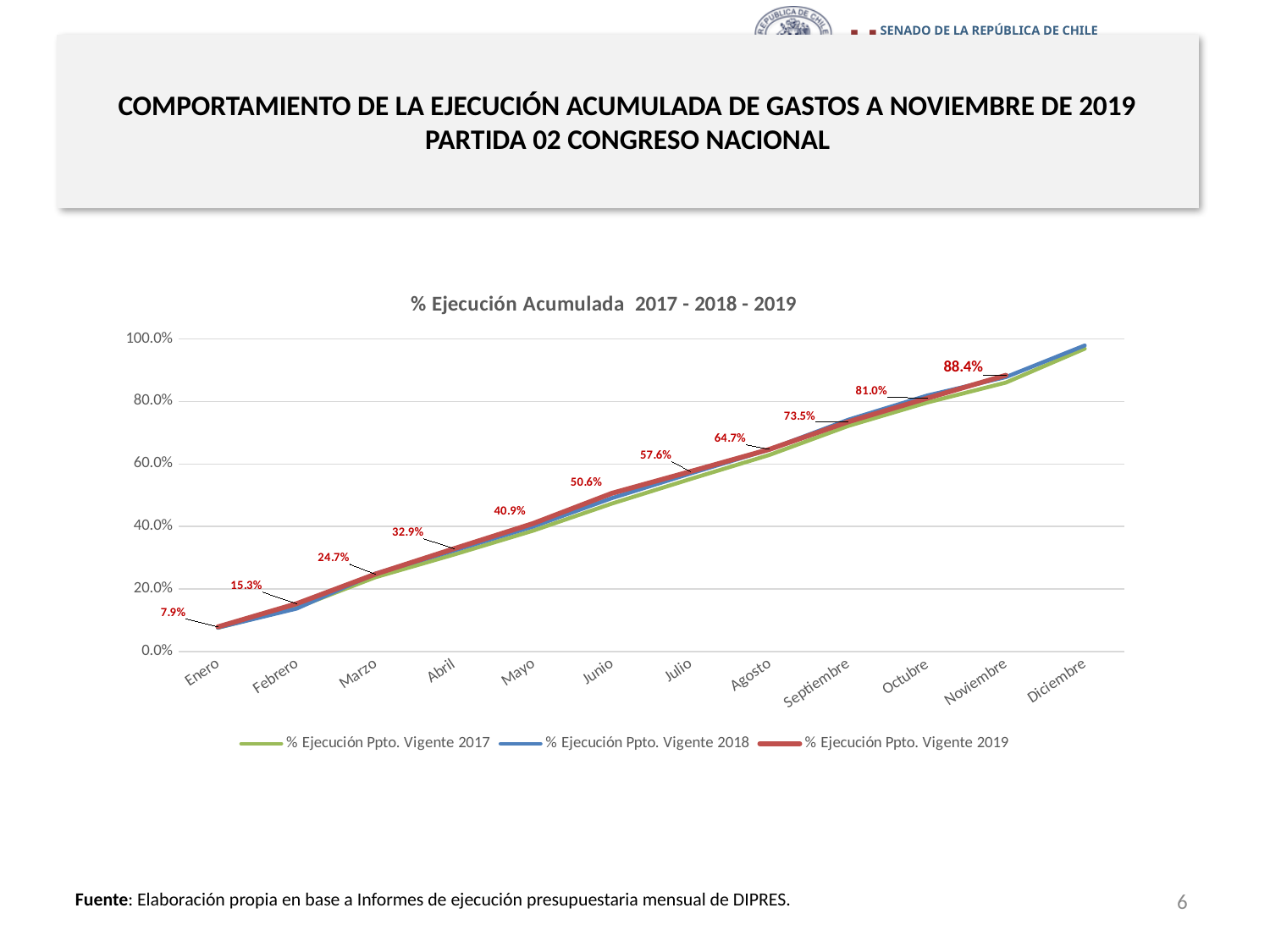
What is the value for % Ejecución Ppto. Vigente 2019 in Septiembre? 73.5% In which month is the % Ejecución Ppto. Vigente 2019 value lowest? Enero What is the difference between the % Ejecución Ppto. Vigente 2019 values for Marzo and Febrero? 9.4% What is the value for % Ejecución Ppto. Vigente 2019 in Junio? 50.6% How many months are shown on the x axis of the chart? 12 What kind of chart is shown on the slide? line chart What is the difference between the % Ejecución Ppto. Vigente 2019 values for Noviembre and Octubre? 7.4% Is the value for % Ejecución Ppto. Vigente 2017 in Diciembre greater or less than 80.0%? greater What is the value for % Ejecución Ppto. Vigente 2019 in Noviembre? 88.4% In which month does the % Ejecución Ppto. Vigente 2019 series reach its highest labelled value? Noviembre What is the value for % Ejecución Ppto. Vigente 2019 in Enero? 7.9% How many series does the legend list? 3